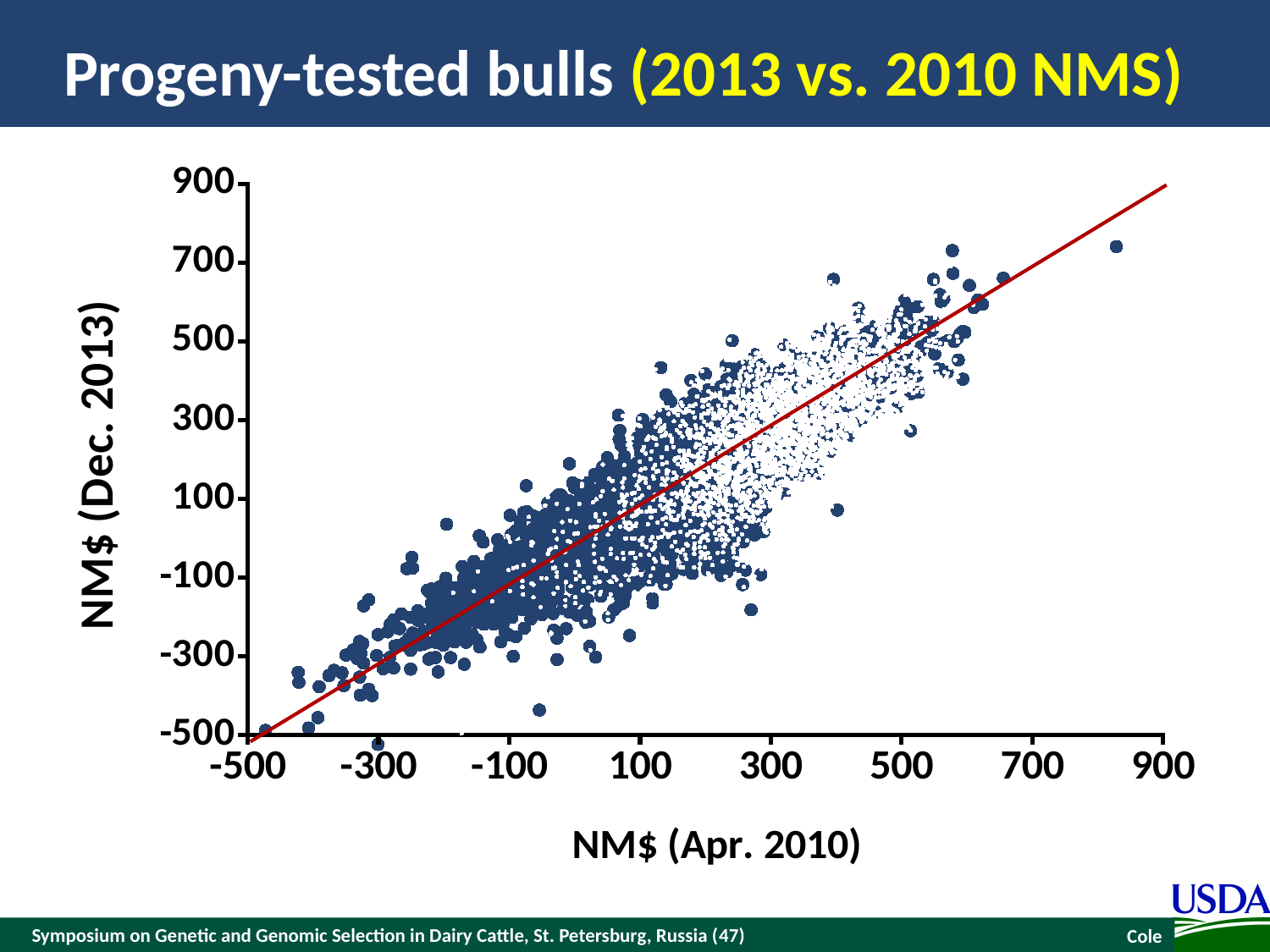
What is the label of the x axis? NM$ (Apr. 2010) What is the label of the y axis? NM$ (Dec. 2013) Is the NM$ (Apr. 2010) value of the rightmost point greater or less than 700? greater What kind of chart is shown on the slide? Scatter plot Does the red line slope upward or downward from left to right? Upward Is the NM$ (Dec. 2013) value of the lowest point greater or less than -300? less Is the NM$ (Apr. 2010) value of the leftmost point greater or less than -300? less As NM$ (Apr. 2010) increases along the x axis, do the NM$ (Dec. 2013) values generally rise or fall? Rise